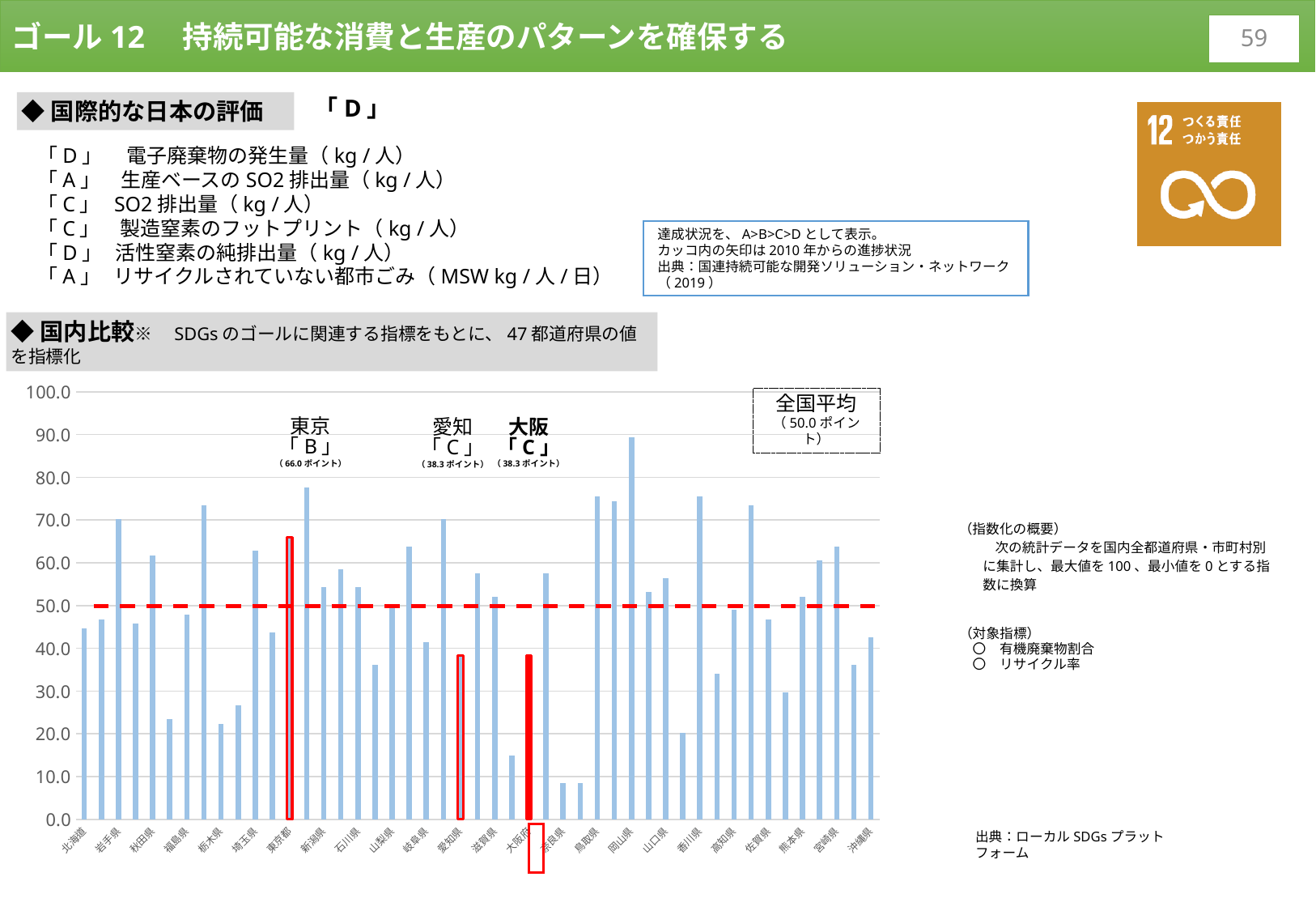
Is the value for 岩手県 greater or less than 60.0? greater What kind of chart is shown on the slide? bar chart Is the value for 北海道 greater or less than 50.0? less What is the value for 東京 in the bar chart? 66.0 ポイント What is the difference between the values for 東京 and 愛知? 27.7 ポイント What is the 全国平均 value shown on the chart? 50.0 ポイント Which prefecture has the highest bar in the chart? 岡山県 What does the red dashed horizontal line on the chart represent? 全国平均 (50.0 ポイント) What is the value for 大阪 in the bar chart? 38.3 ポイント Is the value for 奈良県 greater or less than 10.0? less What is the value for 愛知 in the bar chart? 38.3 ポイント Which has the larger value, 東京 or 大阪? 東京